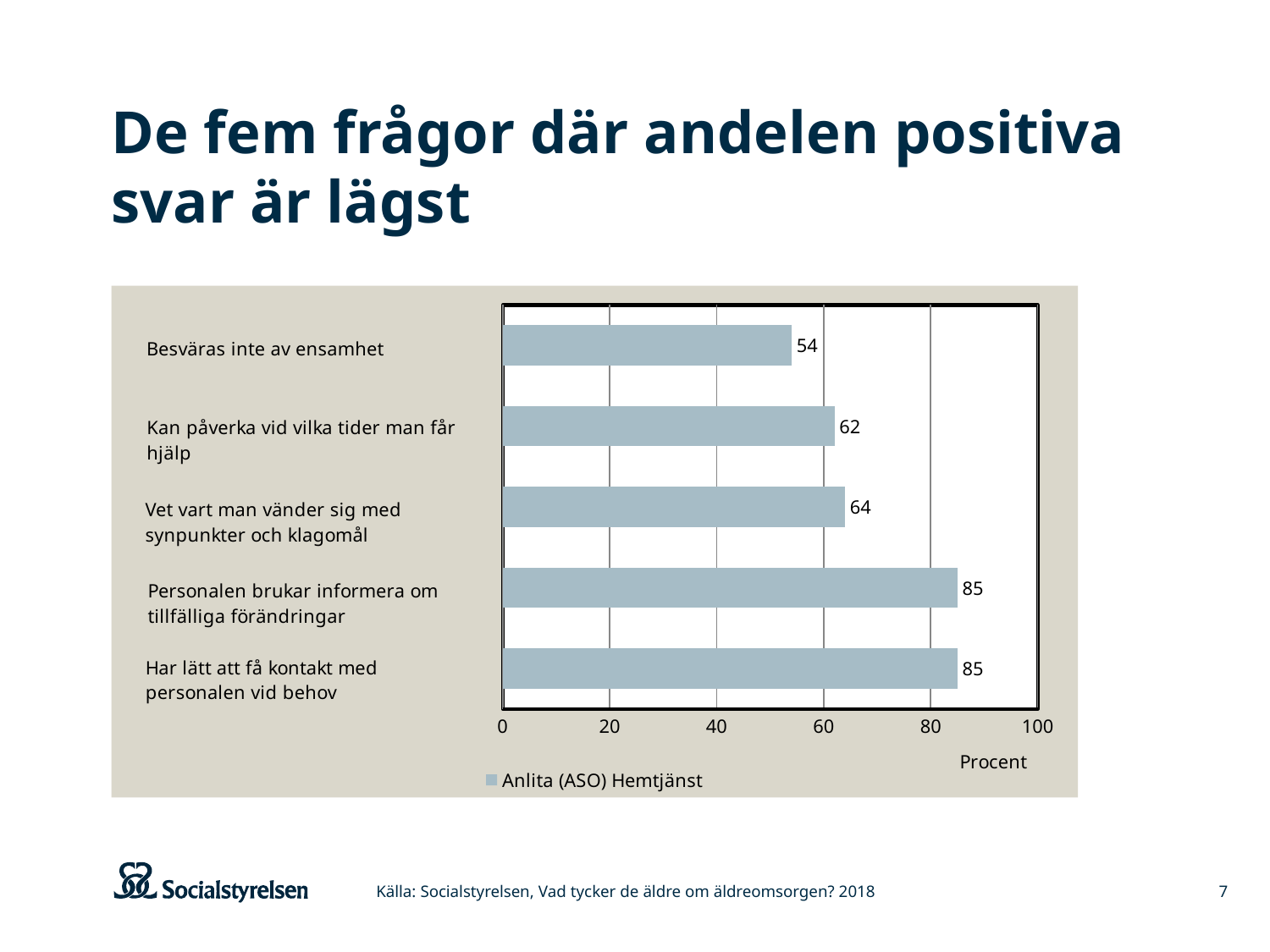
What is the value for "Besväras inte av ensamhet"? 54 Which is larger: the value for "Kan påverka vid vilka tider man får hjälp" or the value for "Besväras inte av ensamhet"? Kan påverka vid vilka tider man får hjälp What is the value for "Kan påverka vid vilka tider man får hjälp"? 62 What is the value for "Har lätt att få kontakt med personalen vid behov"? 85 Is the value for "Besväras inte av ensamhet" greater or less than 60? less How many categories are shown in the chart? 5 What is the value for "Vet vart man vänder sig med synpunkter och klagomål"? 64 Which category has the lowest value? Besväras inte av ensamhet What kind of chart is shown on the slide? bar chart What is the difference between the values for "Personalen brukar informera om tillfälliga förändringar" and "Besväras inte av ensamhet"? 31 What is the difference between the values for "Vet vart man vänder sig med synpunkter och klagomål" and "Kan påverka vid vilka tider man får hjälp"? 2 What series name does the legend show? Anlita (ASO) Hemtjänst